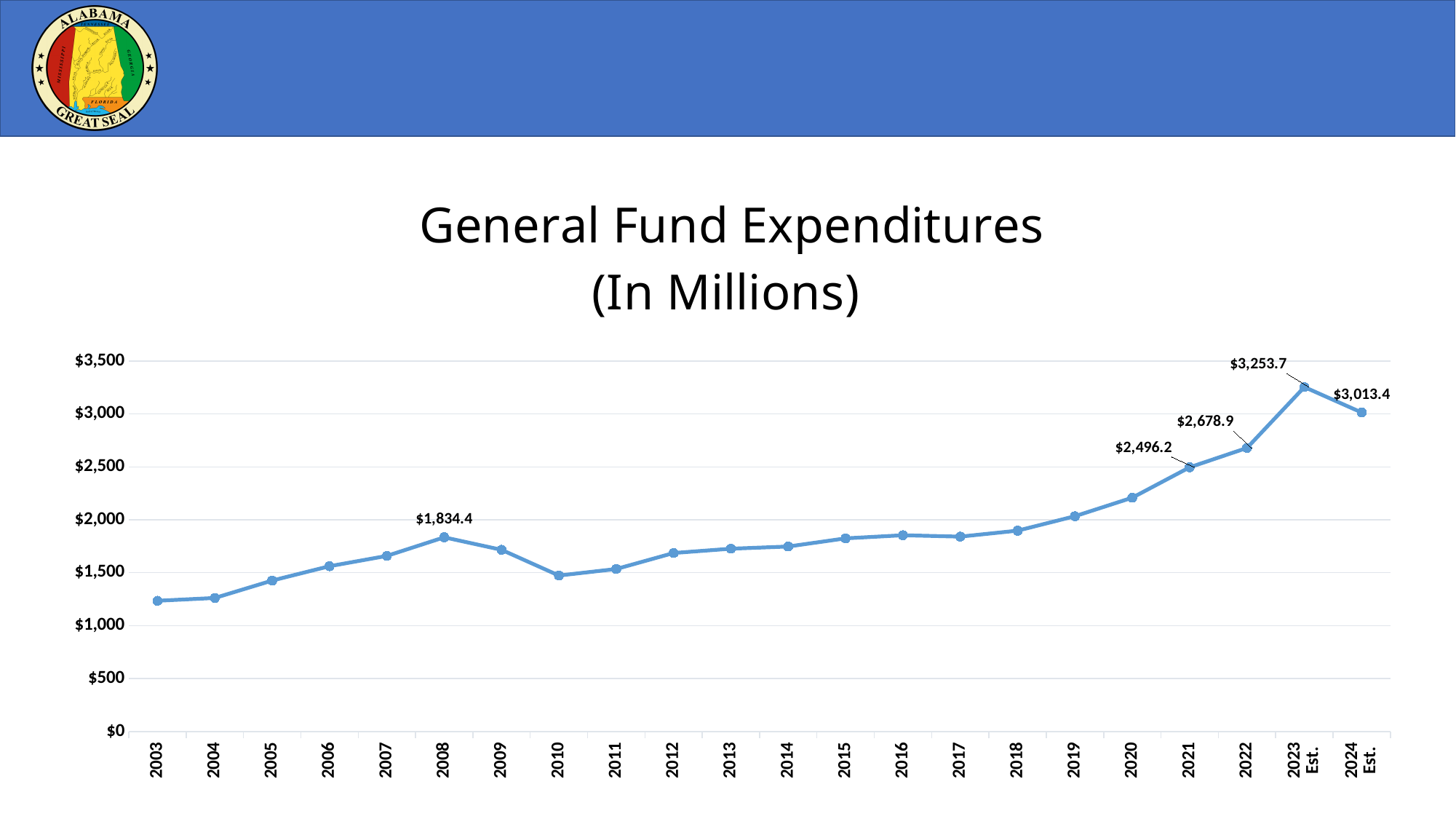
What is the value for 2022? $2,678.9 How many years are plotted on the x axis? 22 What is the value for 2021? $2,496.2 What is the value for 2024 Est.? $3,013.4 Which year has the highest value? 2023 Est. What is the title of the chart? General Fund Expenditures (In Millions) What is the value for 2008? $1,834.4 What is the value for 2023 Est.? $3,253.7 What type of chart is shown on the slide? line chart What is the difference between the values for 2023 Est. and 2024 Est.? $240.3